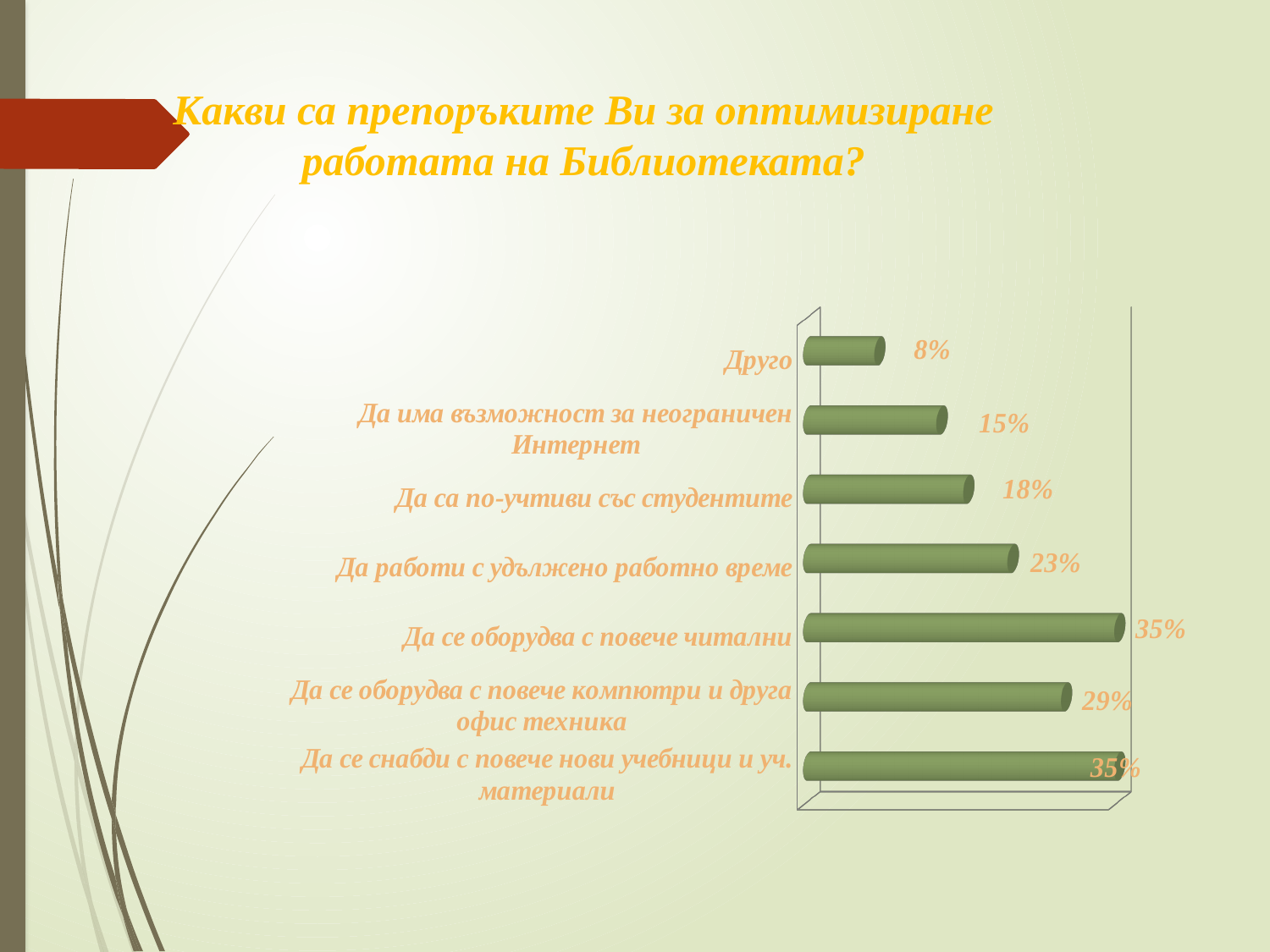
Which category has the lowest value? Друго What percentage of respondents recommended "Да се оборудва с повече читални"? 35% What is the title of the slide above the chart? Какви са препоръките Ви за оптимизиране работата на Библиотеката? What is the value shown for "Друго"? 8% What type of chart is shown on the slide? Bar chart What is the value for "Да се оборудва с повече компютри и друга офис техника"? 29% What percentage is shown for "Да работи с удължено работно време"? 23% What percentage is shown for "Да има възможност за неограничен Интернет"? 15% How many categories are shown in the chart? 7 What is the difference between "Да са по-учтиви със студентите" and "Друго"? 10% What is the difference between the values for "Да се оборудва с повече читални" and "Да се оборудва с повече компютри и друга офис техника"? 6% Which is larger: the value for "Да работи с удължено работно време" or for "Да са по-учтиви със студентите"? Да работи с удължено работно време